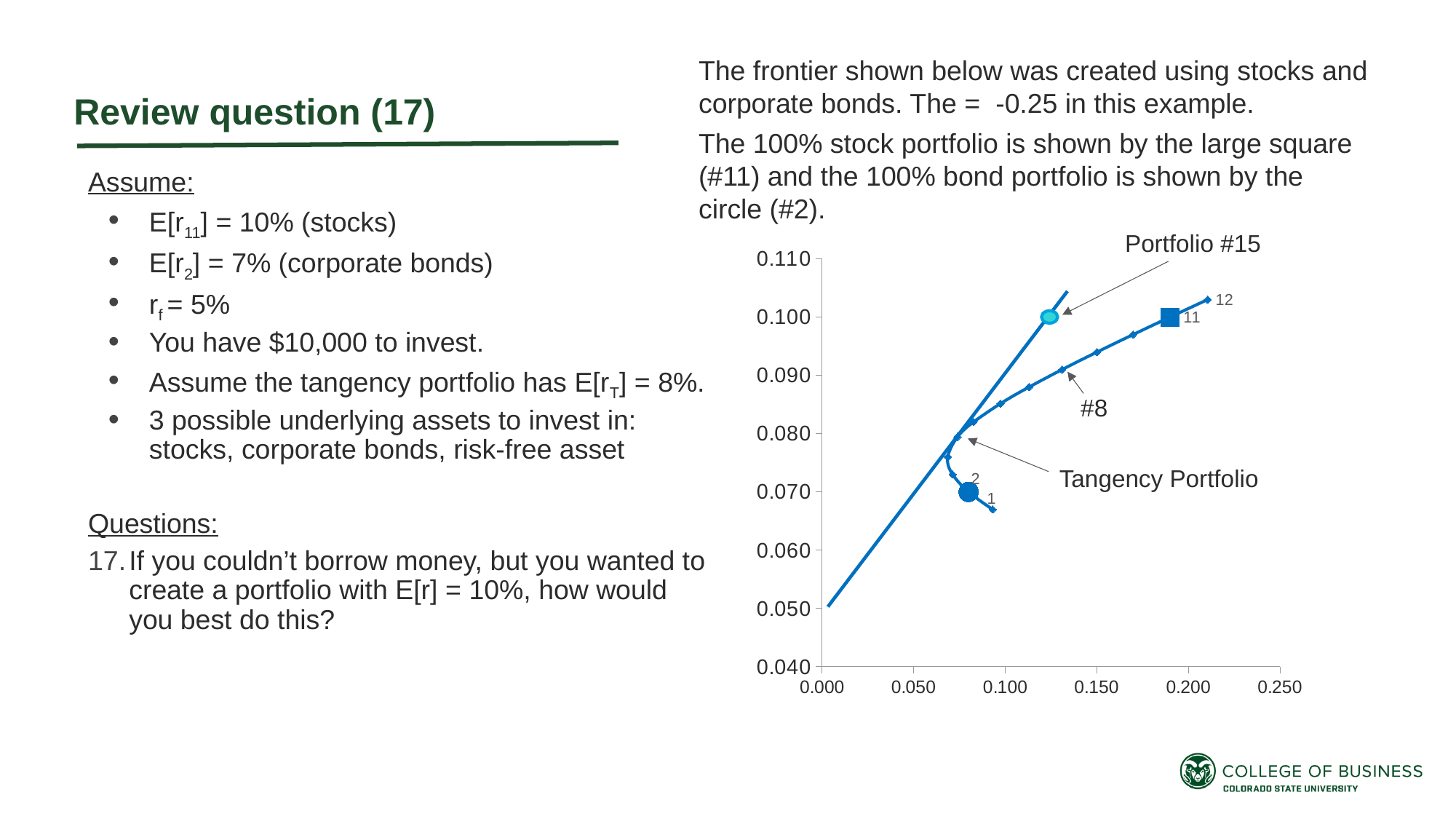
What is the highest value shown on the y-axis? 0.110 Is the x-axis value of the square labeled 11 greater or less than 0.150? greater Which labeled point on the curved frontier has the highest y-axis value? 12 What is the y-axis value of the point labeled Portfolio #15? 0.100 Which point has the higher y-axis value, the square labeled 11 or the circle labeled 2? 11 What kind of chart is shown on the slide? scatter chart Is the x-axis value of the Tangency Portfolio greater or less than 0.100? less What is the y-axis value of the large circle labeled 2? 0.070 Is the y-axis value of point 12 greater or less than 0.100? greater Which labeled point on the curved frontier has the lowest y-axis value? 1 What is the y-axis value of the large square labeled 11? 0.100 At what y-axis value does the straight line meet the vertical axis (x = 0.000)? 0.050